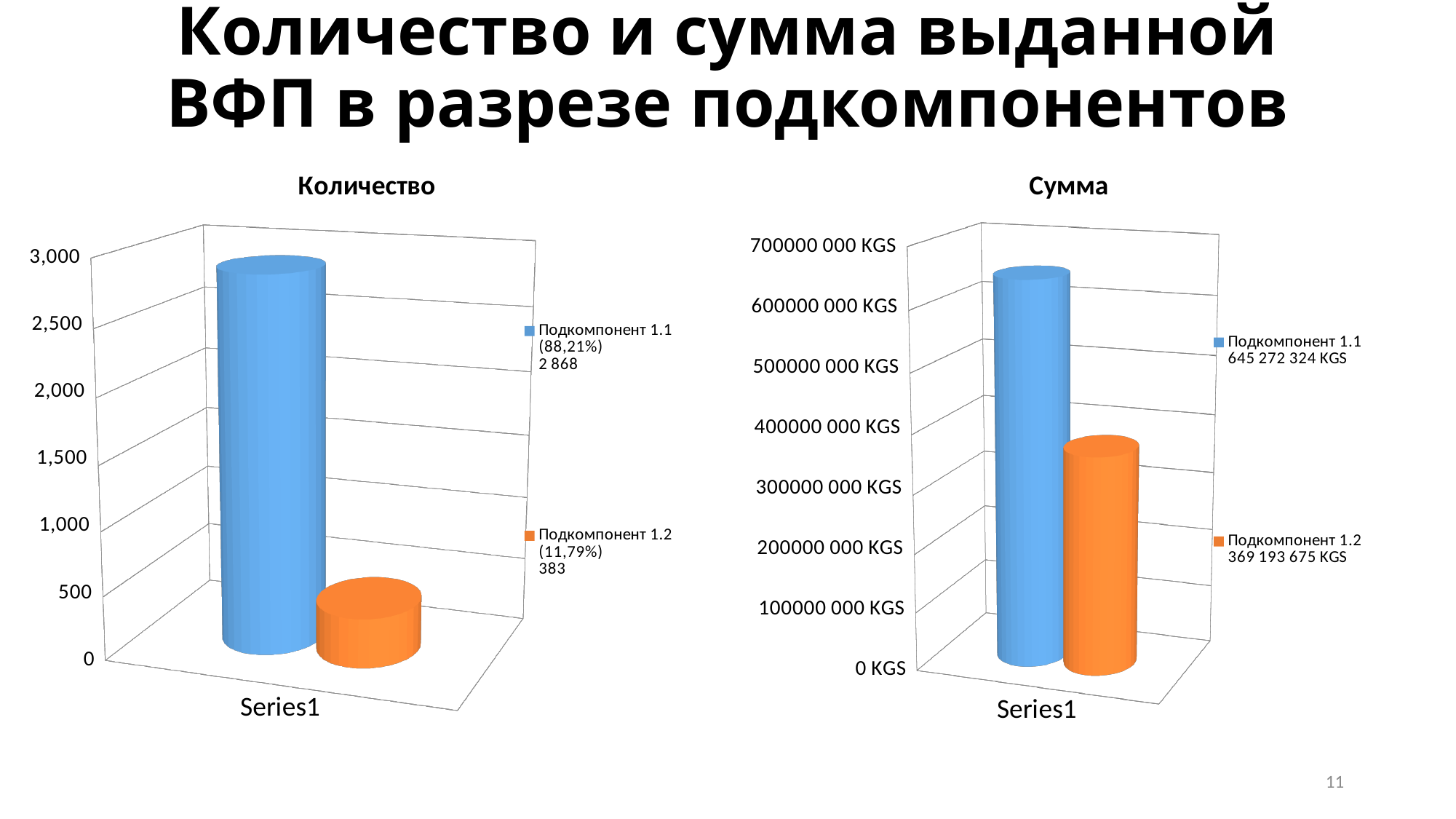
In the "Сумма" chart, what is the value for Подкомпонент 1.1? 645 272 324 KGS In the "Количество" chart, what is the value for Подкомпонент 1.1? 2 868 In the "Сумма" chart, which subcomponent has the lower value? Подкомпонент 1.2 In the "Количество" chart, what is the difference between Подкомпонент 1.1 and Подкомпонент 1.2? 2 485 How many series does the legend of the "Сумма" chart list? 2 In the "Сумма" chart, what is the difference between Подкомпонент 1.1 and Подкомпонент 1.2? 276 078 649 KGS In the "Сумма" chart, what is the value for Подкомпонент 1.2? 369 193 675 KGS In the "Количество" chart, what is the value for Подкомпонент 1.2? 383 What kind of chart is the "Количество" chart? Bar chart In the "Количество" chart, what percentage share is shown for Подкомпонент 1.2? 11,79% In the "Количество" chart, which subcomponent has the higher value? Подкомпонент 1.1 In the "Количество" chart, what percentage share is shown for Подкомпонент 1.1? 88,21%